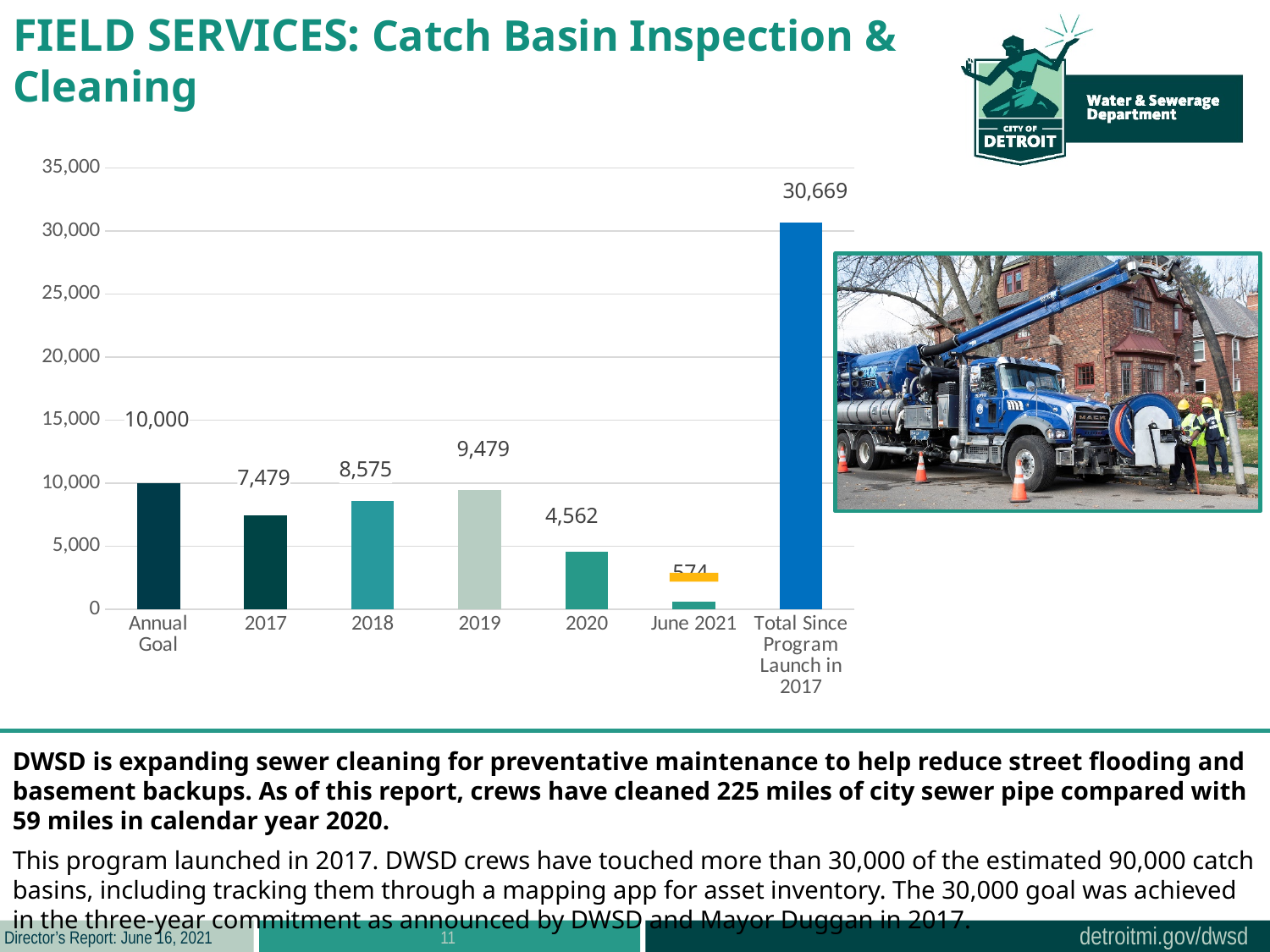
Which category has the highest value? Total Since Program Launch in 2017 What is the value of the Annual Goal bar? 10,000 How many bars are shown in the chart? 7 What value is shown for 2020? 4,562 Do the values rise or fall from 2017 to 2019? rise What value is shown for 2019? 9,479 What value is shown for 2018? 8,575 What is the difference between the 2019 value and the 2018 value? 904 Which category has the lowest value? June 2021 Which is larger, the value for 2017 or the value for 2020? 2017 Is the value for June 2021 greater or less than 5,000? less What is the value of the Total Since Program Launch in 2017 bar? 30,669